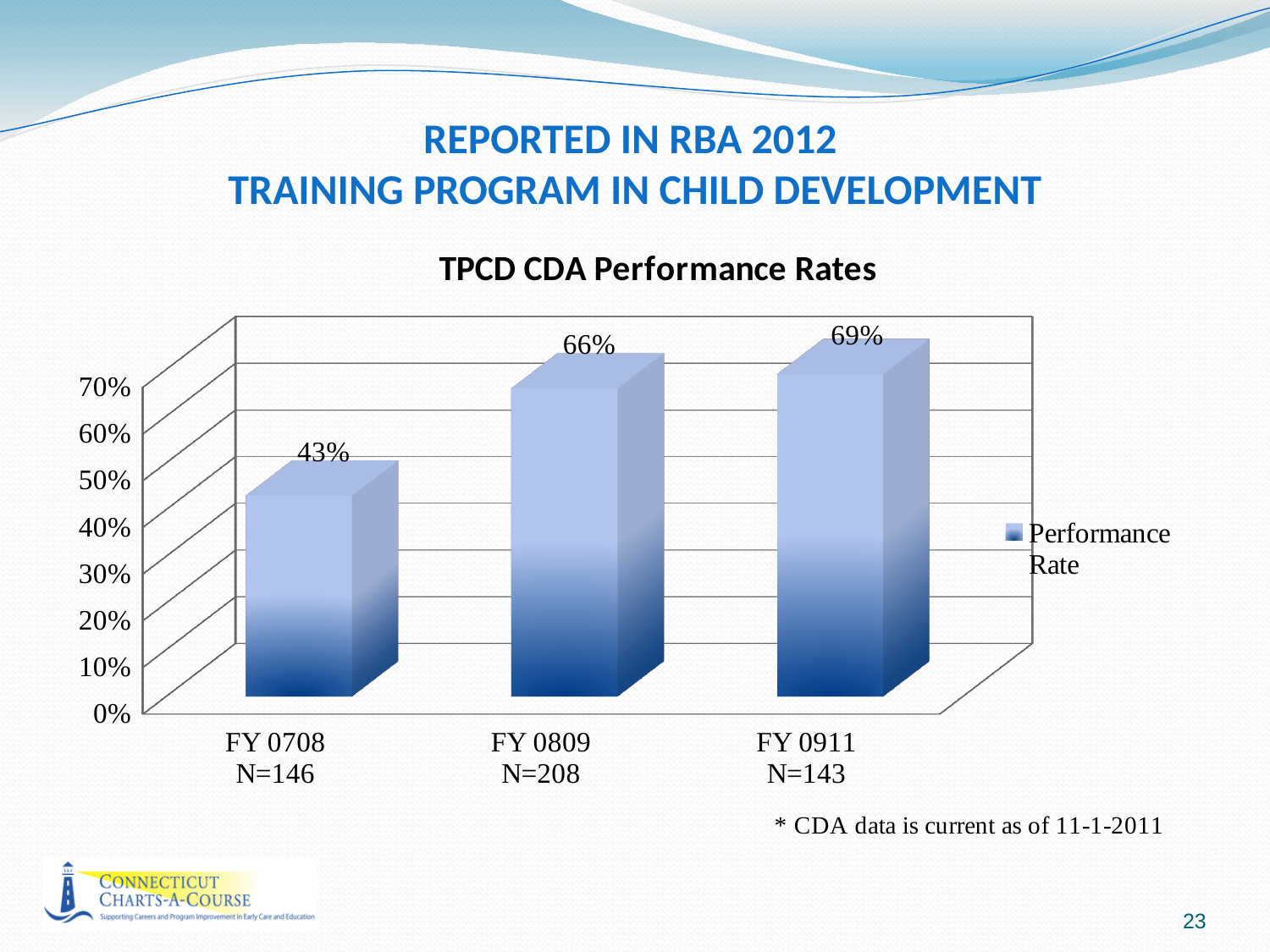
What is the Performance Rate for FY 0809? 66% What is the difference in Performance Rate between FY 0911 and FY 0809? 3% How many fiscal years are shown in the chart? 3 What is the Performance Rate for FY 0708? 43% Which has a higher Performance Rate, FY 0708 or FY 0809? FY 0809 What is the Performance Rate for FY 0911? 69% How many series does the legend list? 1 Do the Performance Rates rise or fall from FY 0708 to FY 0911? Rise What is the difference in Performance Rate between FY 0809 and FY 0708? 23% Which fiscal year has the lowest Performance Rate? FY 0708 What kind of chart is shown on the slide? Bar chart Which fiscal year has the highest Performance Rate? FY 0911